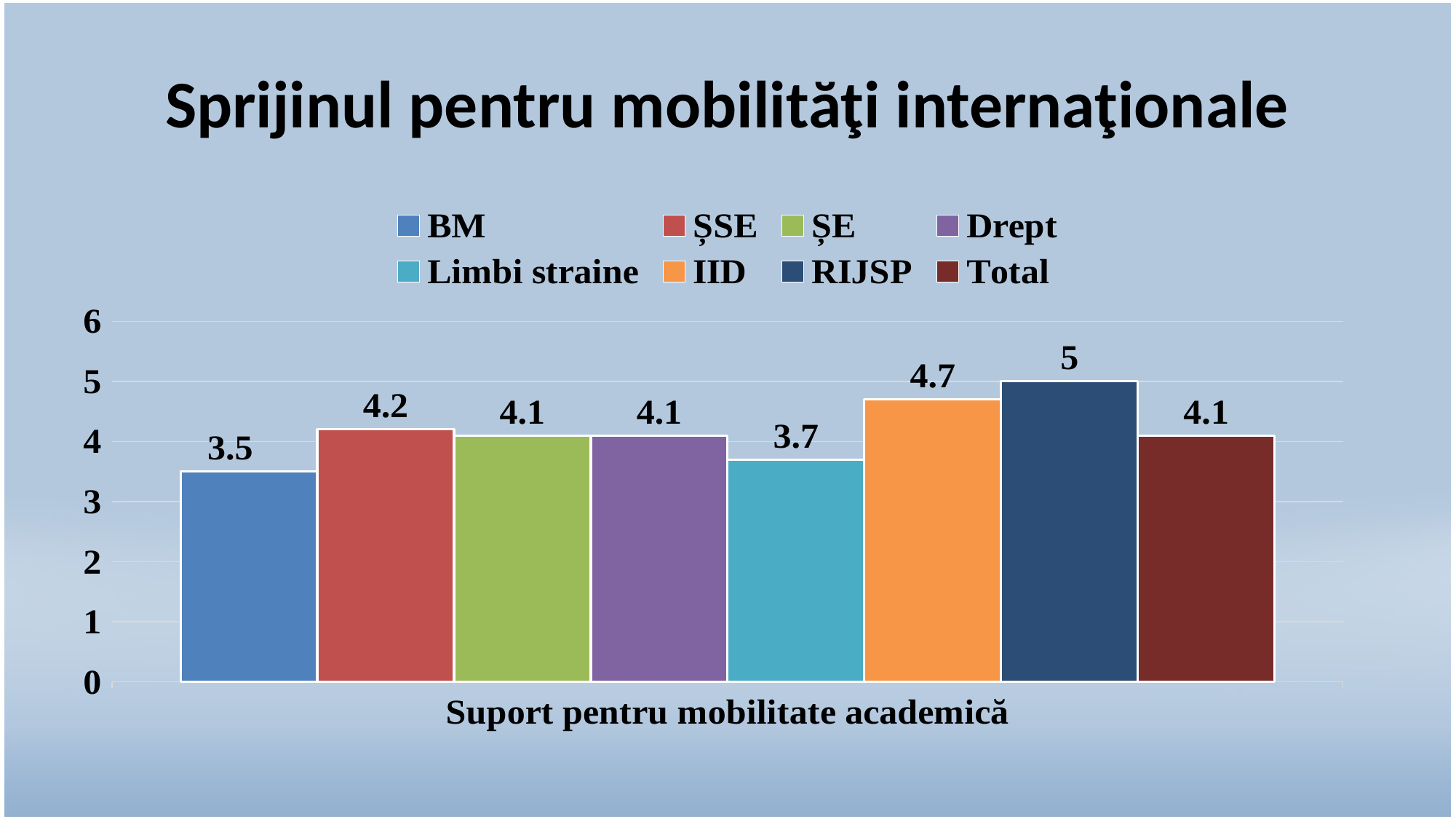
Which series has the lowest value? BM What is the value for IID? 4.7 What is the difference between the values for RIJSP and BM? 1.5 What is the title of the chart? Sprijinul pentru mobilităţi internaţionale What is the value for Limbi straine? 3.7 What is the difference between the values for IID and ȘSE? 0.5 What is the value for Total? 4.1 How many series does the legend list? 8 Which is larger, the value for ȘSE or the value for Limbi straine? ȘSE What kind of chart is shown on the slide? bar chart Which series has the highest value? RIJSP What is the value for BM? 3.5